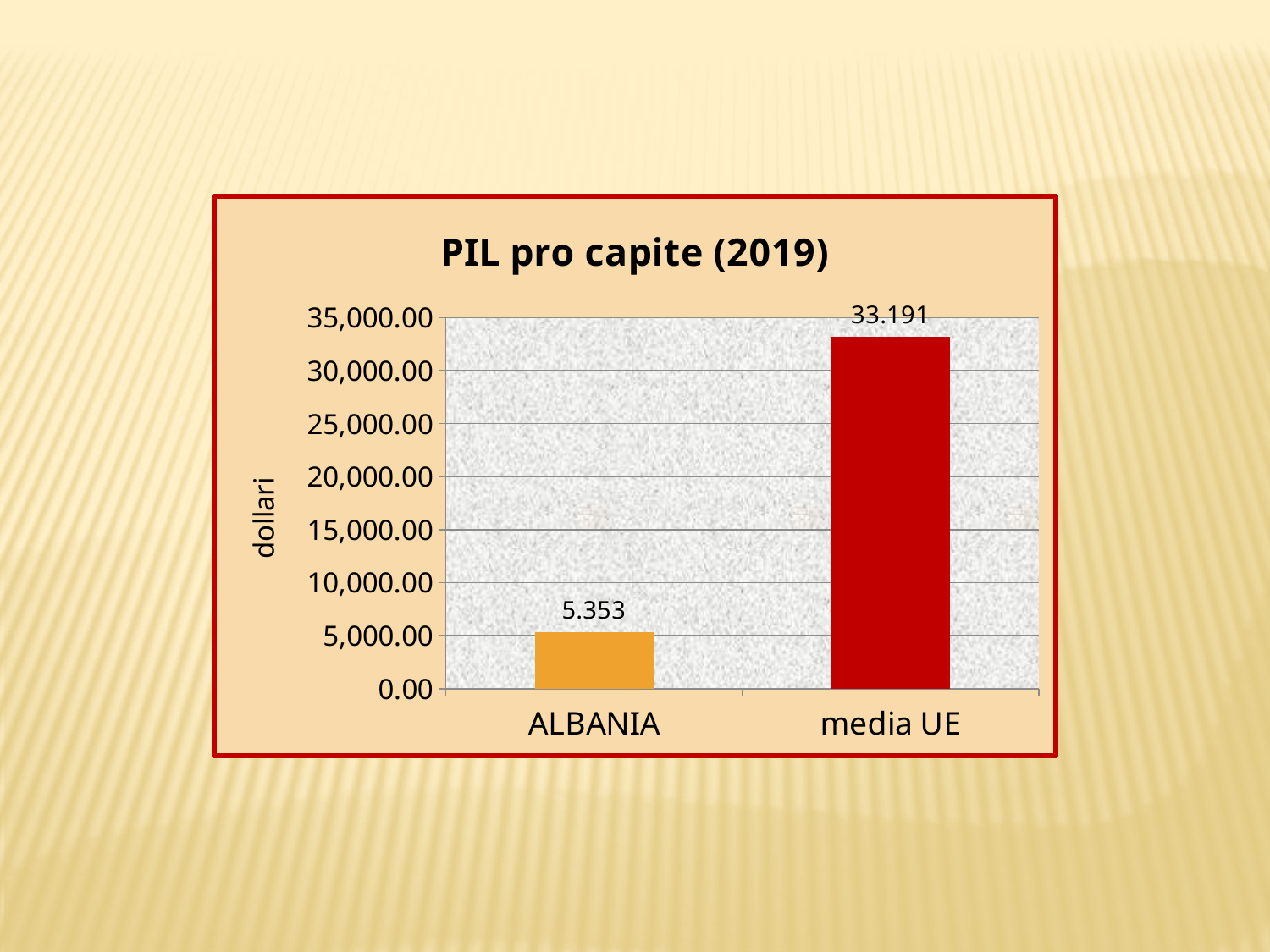
Is the value for ALBANIA greater or less than 10,000.00? less What is the difference between the value for media UE and the value for ALBANIA? 27.838 How many categories are shown on the x axis? 2 What is the value shown for media UE? 33.191 What kind of chart is shown on the slide? bar chart Which category has the highest value? media UE What is the value shown for ALBANIA? 5.353 Is the value for media UE greater or less than 30,000.00? greater What is the label of the vertical axis? dollari What is the title of the chart? PIL pro capite (2019) Which category has the lowest value? ALBANIA Which is larger, the value for ALBANIA or the value for media UE? media UE